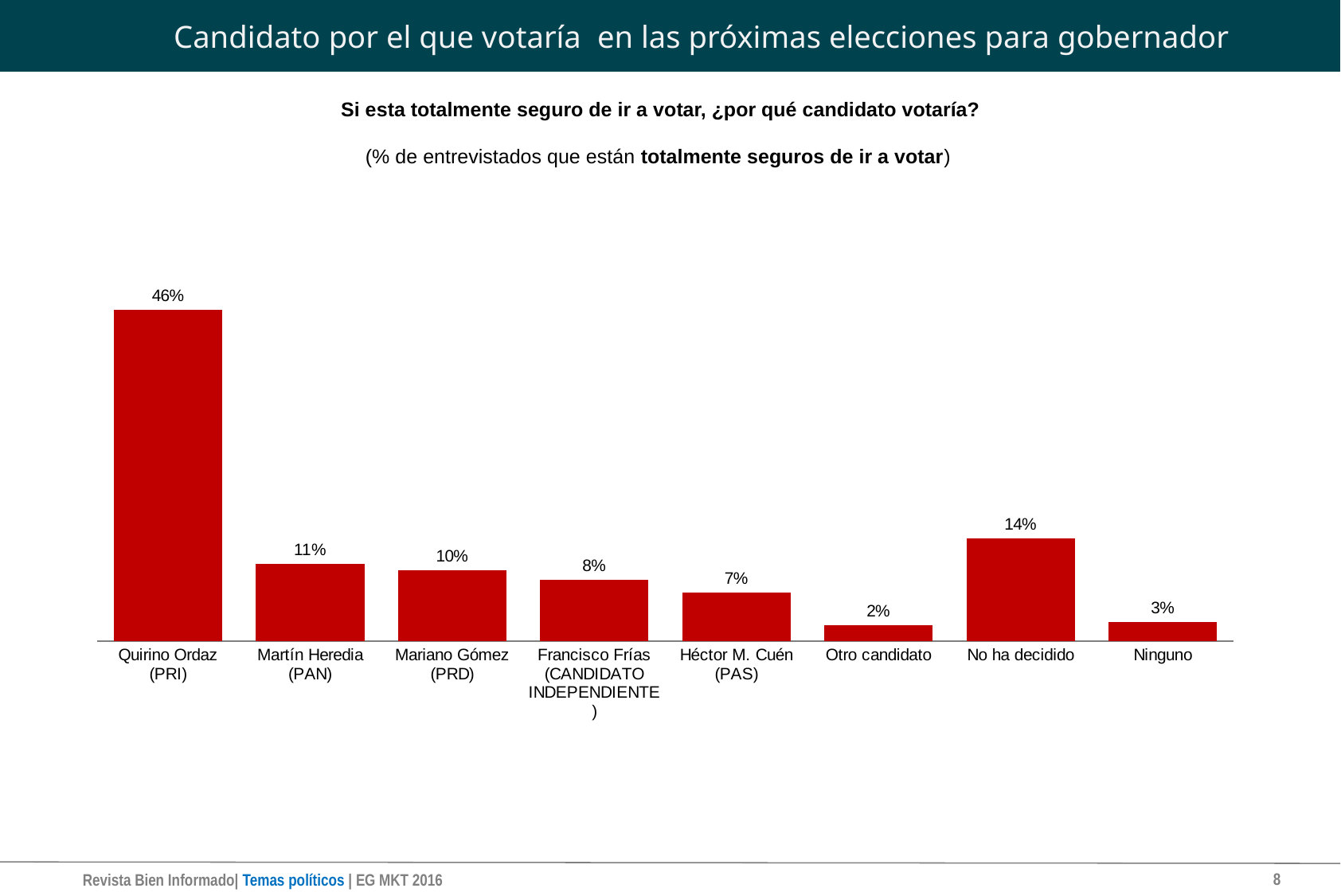
How many categories are shown on the x axis of the chart? 8 What is the difference between 'No ha decidido' and 'Ninguno'? 11 percentage points What is the difference between the values for Quirino Ordaz (PRI) and Martín Heredia (PAN)? 35 percentage points What type of chart is shown on the slide? Bar chart Which category has the lowest value in the chart? Otro candidato Which is larger: the value for Mariano Gómez (PRD) or Francisco Frías (CANDIDATO INDEPENDIENTE)? Mariano Gómez (PRD) What percentage of respondents would vote for Quirino Ordaz (PRI)? 46% Which category has the highest value in the chart? Quirino Ordaz (PRI) What colour are the bars in the chart? Red What is the value for Héctor M. Cuén (PAS)? 7% What is the value shown for Martín Heredia (PAN)? 11% What percentage is shown for 'No ha decidido'? 14%